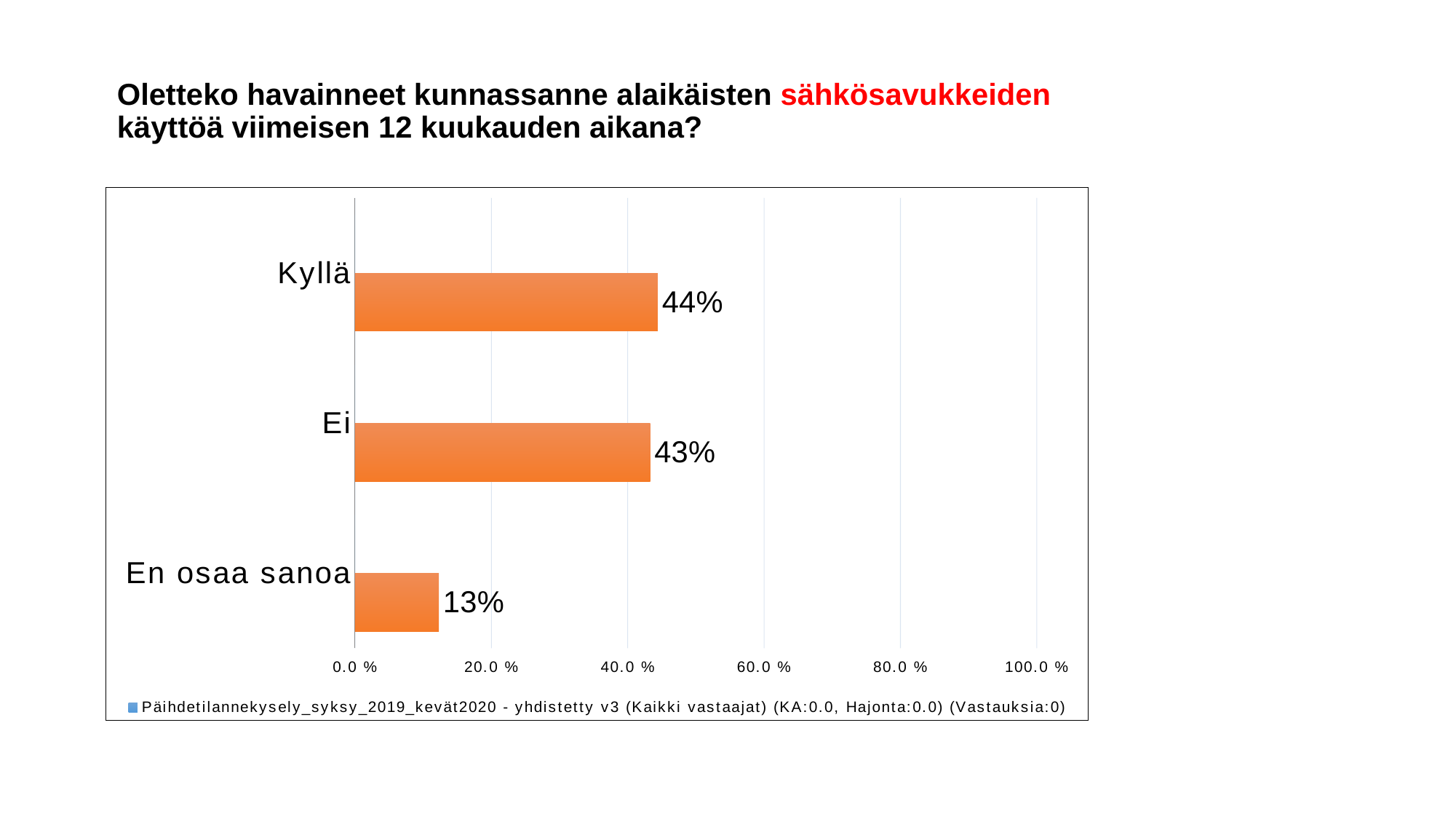
What kind of chart is shown on the slide? Bar chart Is the value for Kyllä greater or less than 40.0 %? greater What is the difference between the values for Kyllä and En osaa sanoa? 31% What is the difference between the values for Ei and En osaa sanoa? 30% Which is larger, the value for Kyllä or the value for En osaa sanoa? Kyllä What is the value for Ei? 43% What is the value for En osaa sanoa? 13% What is the highest value shown on the x axis? 100.0 % Is the value for En osaa sanoa greater or less than 20.0 %? less Which category has the lowest value? En osaa sanoa What is the value for Kyllä? 44% How many categories are shown in the chart? 3